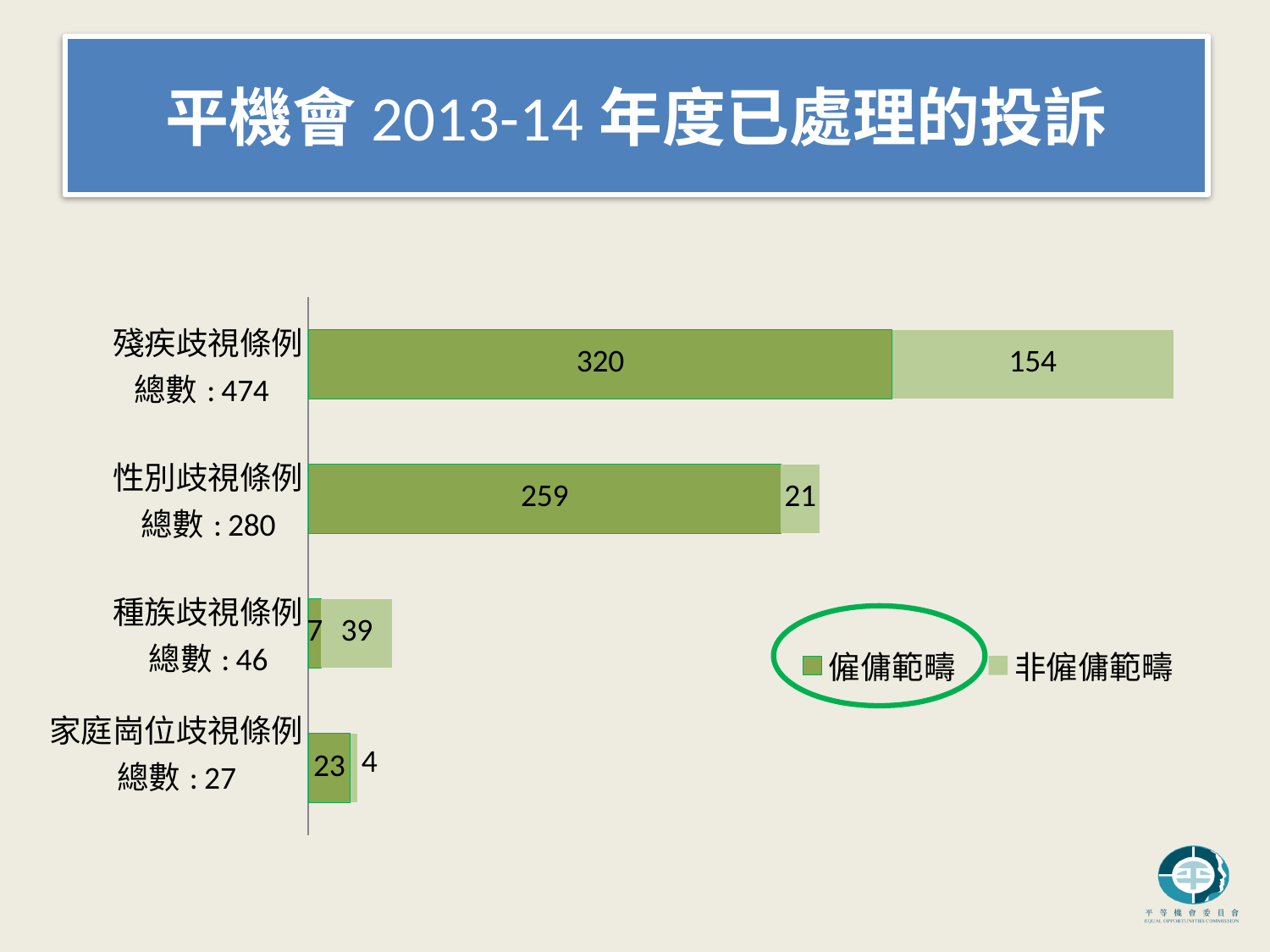
What is the difference between the 僱傭範疇 and 非僱傭範疇 values for 殘疾歧視條例? 166 What kind of chart is shown on the slide? Stacked bar chart How many categories are shown in the chart? 4 What is the 非僱傭範疇 value for 性別歧視條例? 21 Which category has the highest 僱傭範疇 value? 殘疾歧視條例 Which category has the lowest 非僱傭範疇 value? 家庭崗位歧視條例 How many series does the legend list? 2 What is the 僱傭範疇 value for 殘疾歧視條例? 320 What is the 非僱傭範疇 value for 種族歧視條例? 39 What is the 僱傭範疇 value for 家庭崗位歧視條例? 23 What is the total of the stacked bar for 性別歧視條例? 280 For 種族歧視條例, which is larger: 僱傭範疇 or 非僱傭範疇? 非僱傭範疇